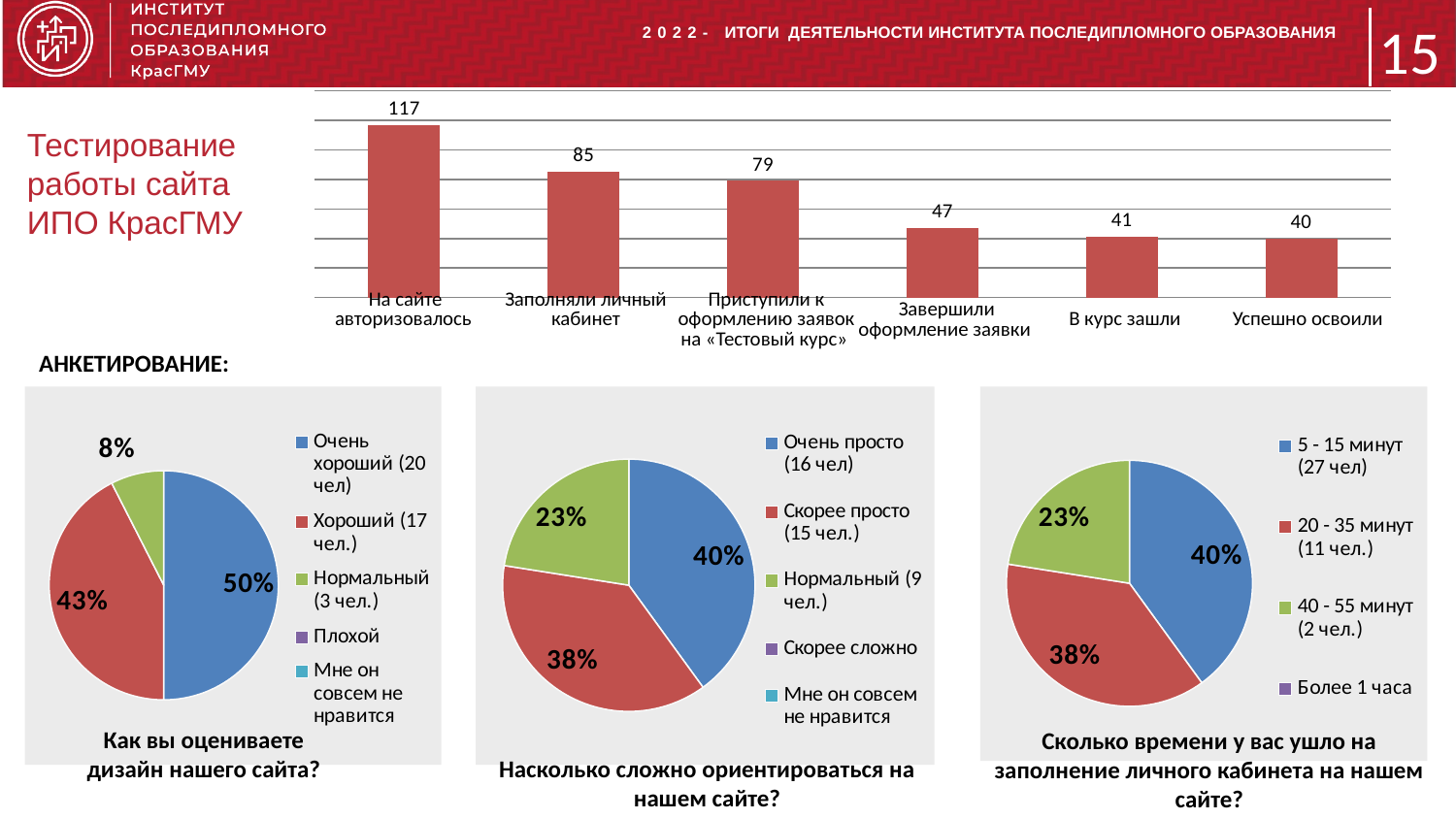
In the bar chart at the top of the slide, do the values rise or fall from left to right? fall In the bar chart at the top of the slide, what is the value for «Завершили оформление заявки»? 47 In the bar chart at the top of the slide, what is the difference between «Заполняли личный кабинет» and «В курс зашли»? 44 In the bar chart at the top of the slide, which category has the lowest value? Успешно освоили What type of chart is used at the top of the slide for the site testing data? bar chart In the bar chart at the top of the slide, what is the value for «На сайте авторизовалось»? 117 In the pie chart «Сколько времени у вас ушло на заполнение личного кабинета на нашем сайте?», which legend entry has the largest share? 5 - 15 минут (27 чел) In the bar chart at the top of the slide, how many categories are shown? 6 In the pie chart «Как вы оцениваете дизайн нашего сайта?», how many entries does the legend list? 5 In the pie chart «Насколько сложно ориентироваться на нашем сайте?», what share is labelled for «Нормальный (9 чел.)»? 23% In the bar chart at the top of the slide, which category has the highest value? На сайте авторизовалось In the pie chart «Как вы оцениваете дизайн нашего сайта?», what share is labelled for «Хороший (17 чел.)»? 43%